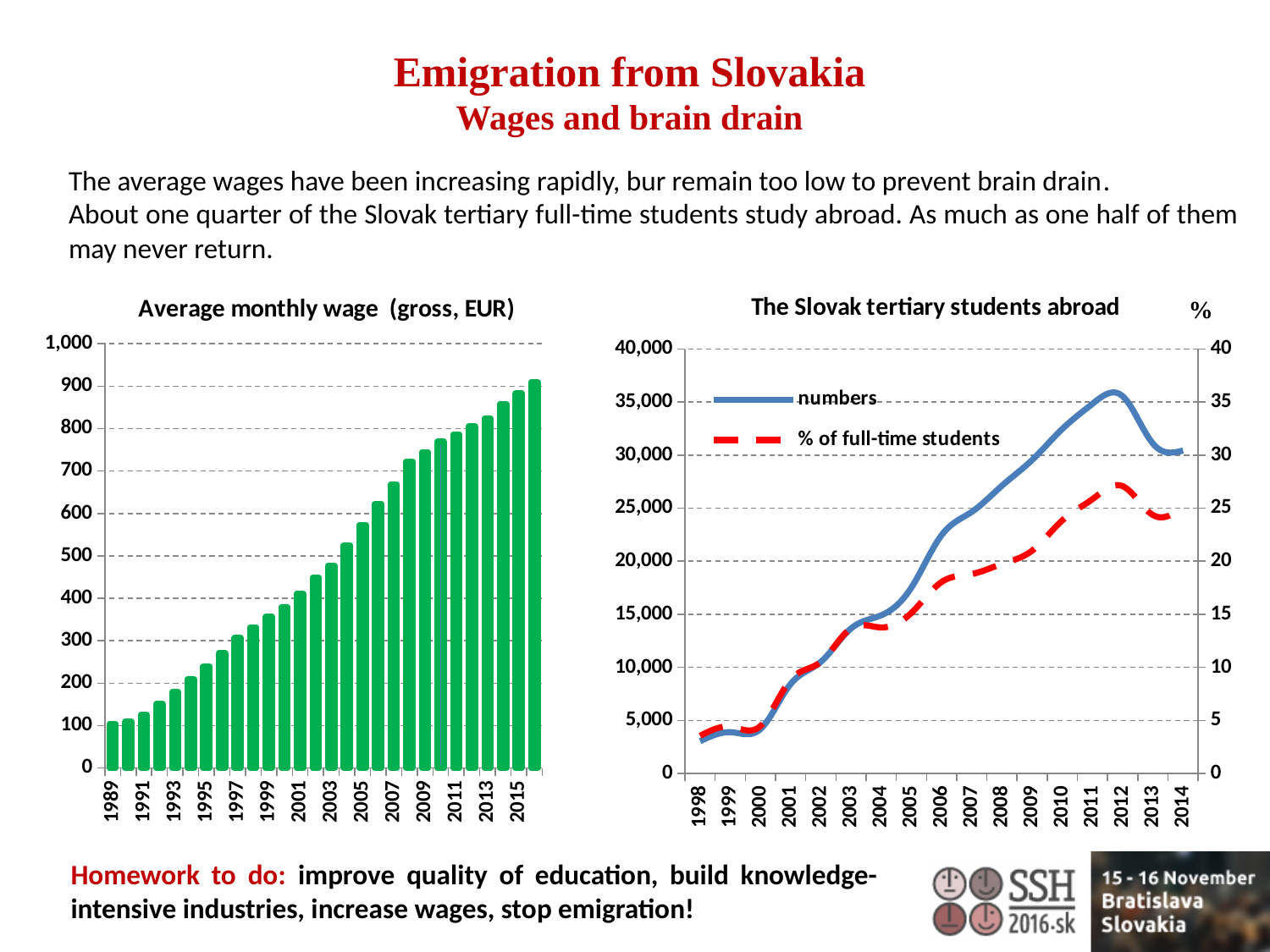
What kind of chart is the 'Average monthly wage (gross, EUR)' chart? bar chart In 'The Slovak tertiary students abroad' chart, is the '% of full-time students' value for 2012 greater or less than 25? greater In the 'Average monthly wage (gross, EUR)' chart, is the value for 2015 greater or less than 800? greater In 'The Slovak tertiary students abroad' chart, which series is drawn as a red dashed line? % of full-time students In 'The Slovak tertiary students abroad' chart, in which year does the 'numbers' series reach its highest value? 2012 What kind of chart is 'The Slovak tertiary students abroad'? line chart How many series does the legend of 'The Slovak tertiary students abroad' chart list? 2 In the 'Average monthly wage (gross, EUR)' chart, is the value for 2005 greater or less than 500? greater In the 'Average monthly wage (gross, EUR)' chart, do the values rise or fall from 1989 to 2015? rise